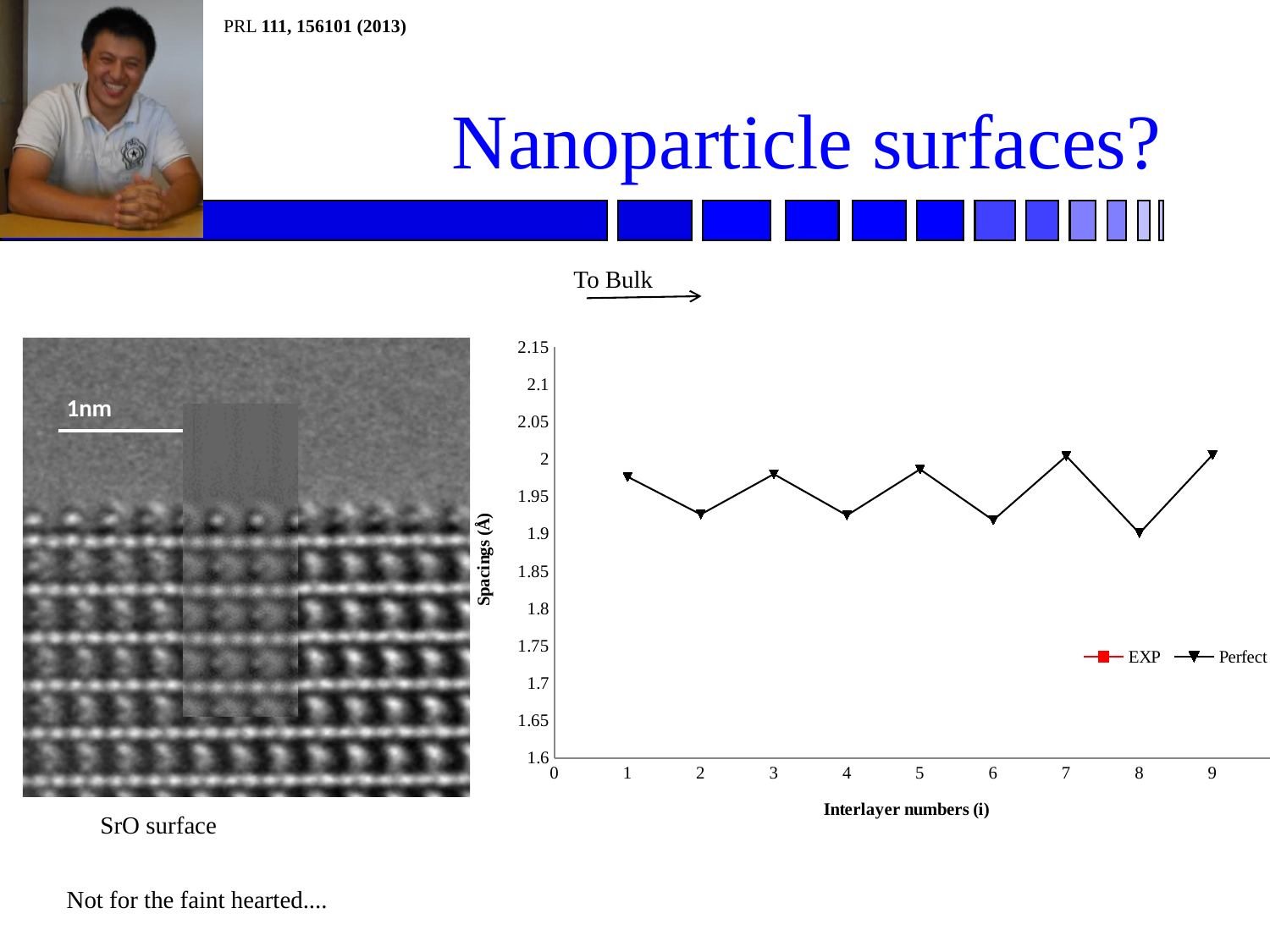
Which has the larger Perfect value, interlayer number 1 or interlayer number 2? 1 Which has the larger Perfect value, interlayer number 7 or interlayer number 8? 7 Is the Perfect value at interlayer number 7 greater or less than 1.95? greater At which interlayer number is the Perfect series lowest? 8 Is the Perfect value at interlayer number 1 greater or less than 1.9? greater Is the Perfect value at interlayer number 6 greater or less than 1.95? less What are the two series named in the chart legend? EXP and Perfect How many data points are plotted for the Perfect series? 9 What kind of chart is shown on the slide? line chart What is the title of the chart's y axis? Spacings (Å) How many series does the chart legend list? 2